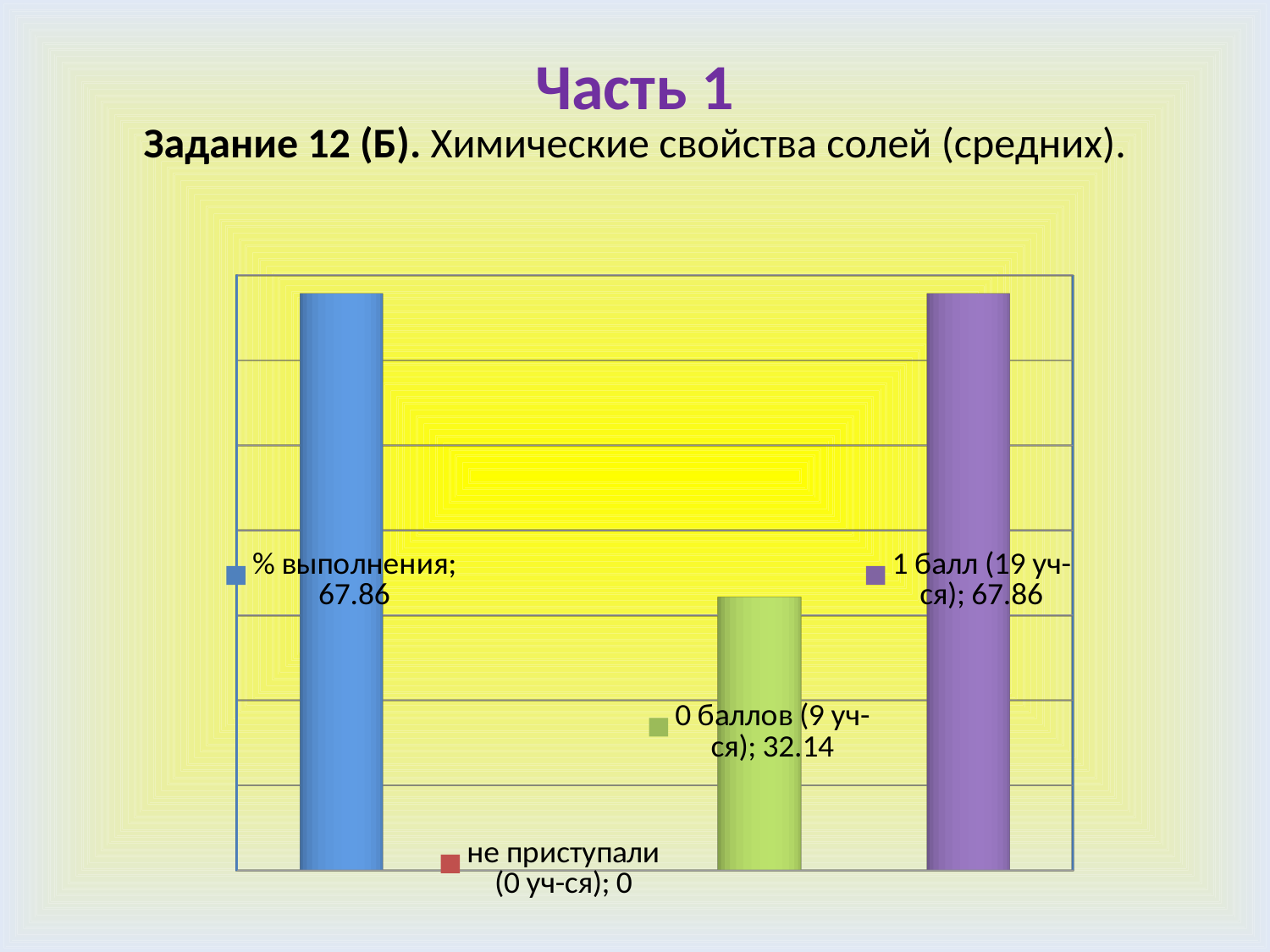
What is the value for "% выполнения"? 67.86 Which category has the lowest value? не приступали (0 уч-ся) What is the difference between the values for "1 балл (19 уч-ся)" and "0 баллов (9 уч-ся)"? 35.72 What is the value for "0 баллов (9 уч-ся)"? 32.14 Which is larger: the value for "0 баллов (9 уч-ся)" or the value for "1 балл (19 уч-ся)"? 1 балл (19 уч-ся) What is the value for "не приступали (0 уч-ся)"? 0 What kind of chart is shown on the slide? bar chart How many bars (categories) does the chart show? 4 What is the value for "1 балл (19 уч-ся)"? 67.86 What is the task named in the slide heading above the chart? Задание 12 (Б). Химические свойства солей (средних). How many students scored 1 балл according to the category label? 19